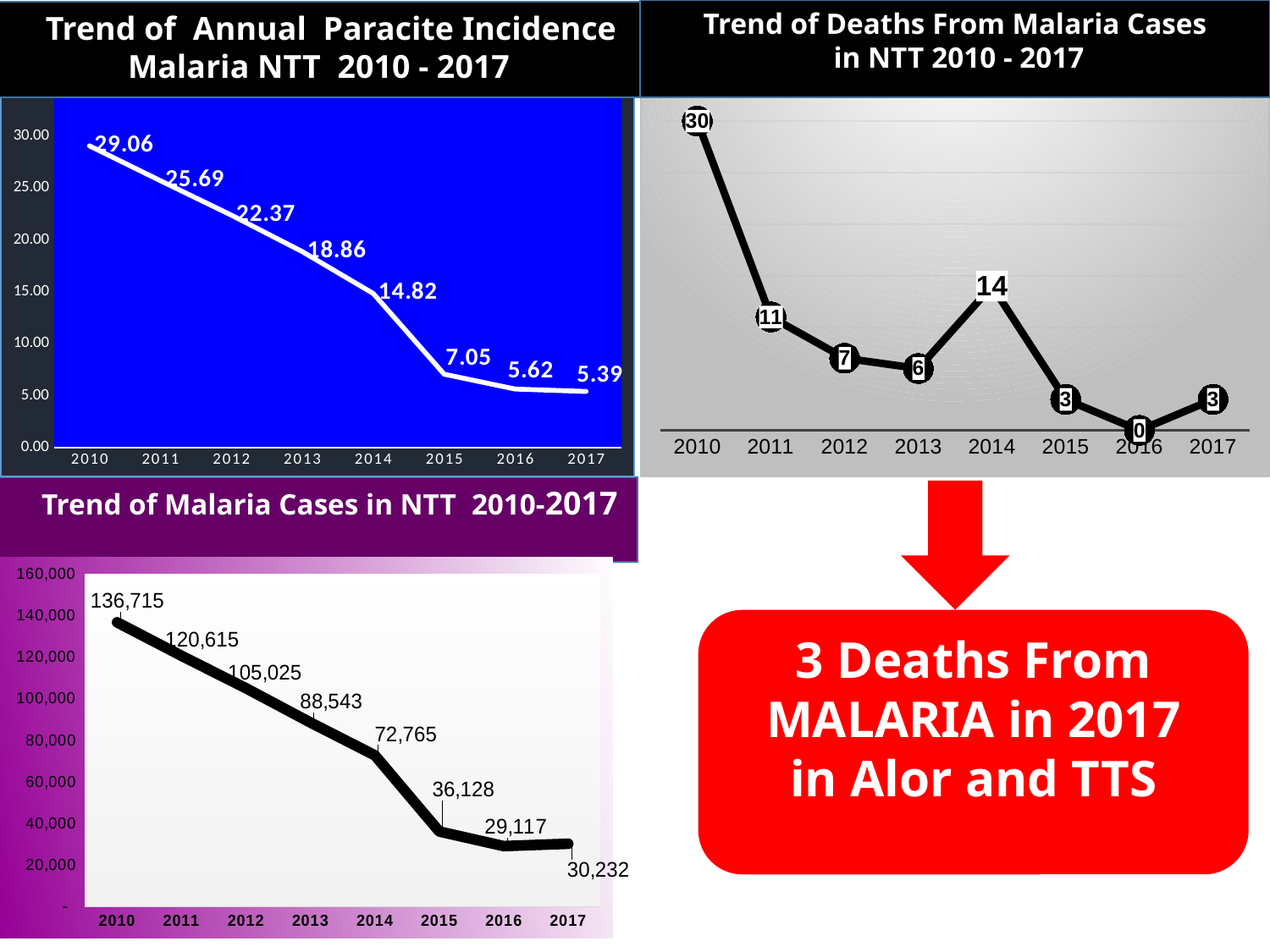
In the 'Trend of Deaths From Malaria Cases in NTT 2010 - 2017' chart, which year has the highest value? 2010 In the 'Trend of Annual Paracite Incidence Malaria NTT 2010 - 2017' chart, what is the value for 2017? 5.39 In the 'Trend of Annual Paracite Incidence Malaria NTT 2010 - 2017' chart, do the values rise or fall from 2010 to 2017? fall In the 'Trend of Annual Paracite Incidence Malaria NTT 2010 - 2017' chart, what is the value for 2010? 29.06 In the 'Trend of Deaths From Malaria Cases in NTT 2010 - 2017' chart, which year has the lowest value? 2016 In the 'Trend of Deaths From Malaria Cases in NTT 2010 - 2017' chart, what is the value for 2014? 14 In the 'Trend of Deaths From Malaria Cases in NTT 2010 - 2017' chart, what is the difference between the values for 2010 and 2011? 19 In the 'Trend of Annual Paracite Incidence Malaria NTT 2010 - 2017' chart, which year has the lowest value? 2017 In the 'Trend of Malaria Cases in NTT 2010-2017' chart, which is larger, the value for 2016 or the value for 2017? 2017 In the 'Trend of Malaria Cases in NTT 2010-2017' chart, how many years are plotted? 8 What kind of chart is the 'Trend of Malaria Cases in NTT 2010-2017' chart? line chart In the 'Trend of Malaria Cases in NTT 2010-2017' chart, what is the value for 2013? 88,543